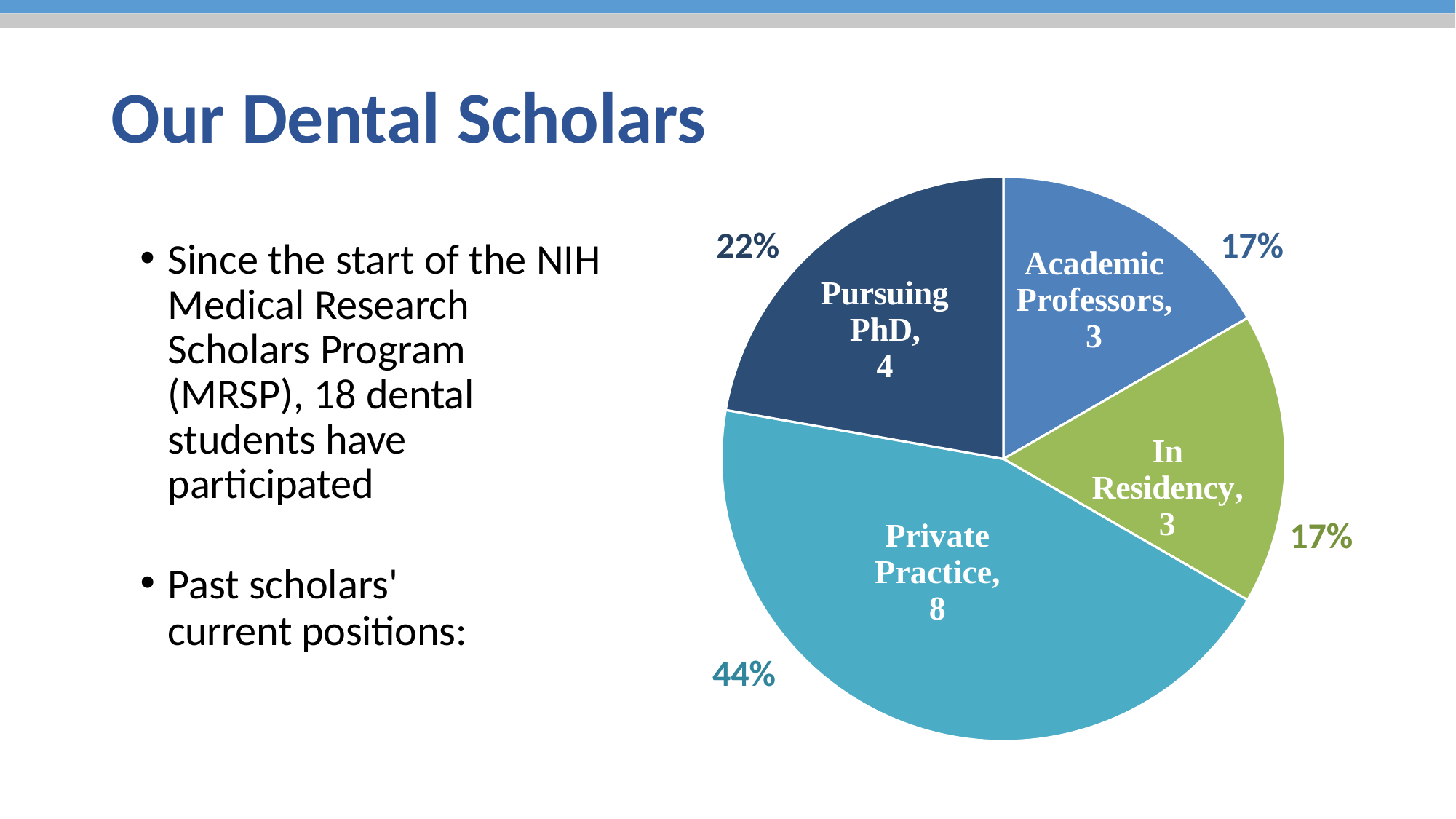
What percentage share of the pie does Private Practice represent? 44% How many slices does the pie chart have? 4 How many past scholars are in Private Practice according to the pie chart? 8 Which category has the largest slice of the pie chart? Private Practice Which is larger: the number of scholars Pursuing PhD or the number In Residency? Pursuing PhD What percentage share of the pie does In Residency represent? 17% What percentage share of the pie does Pursuing PhD represent? 22% What kind of chart is shown on the slide? Pie chart How many past scholars are Academic Professors according to the pie chart? 3 What is the difference between the number of scholars in Private Practice and the number Pursuing PhD? 4 How many past scholars are Pursuing PhD according to the pie chart? 4 What is the total number of scholars across all slices of the pie chart? 18